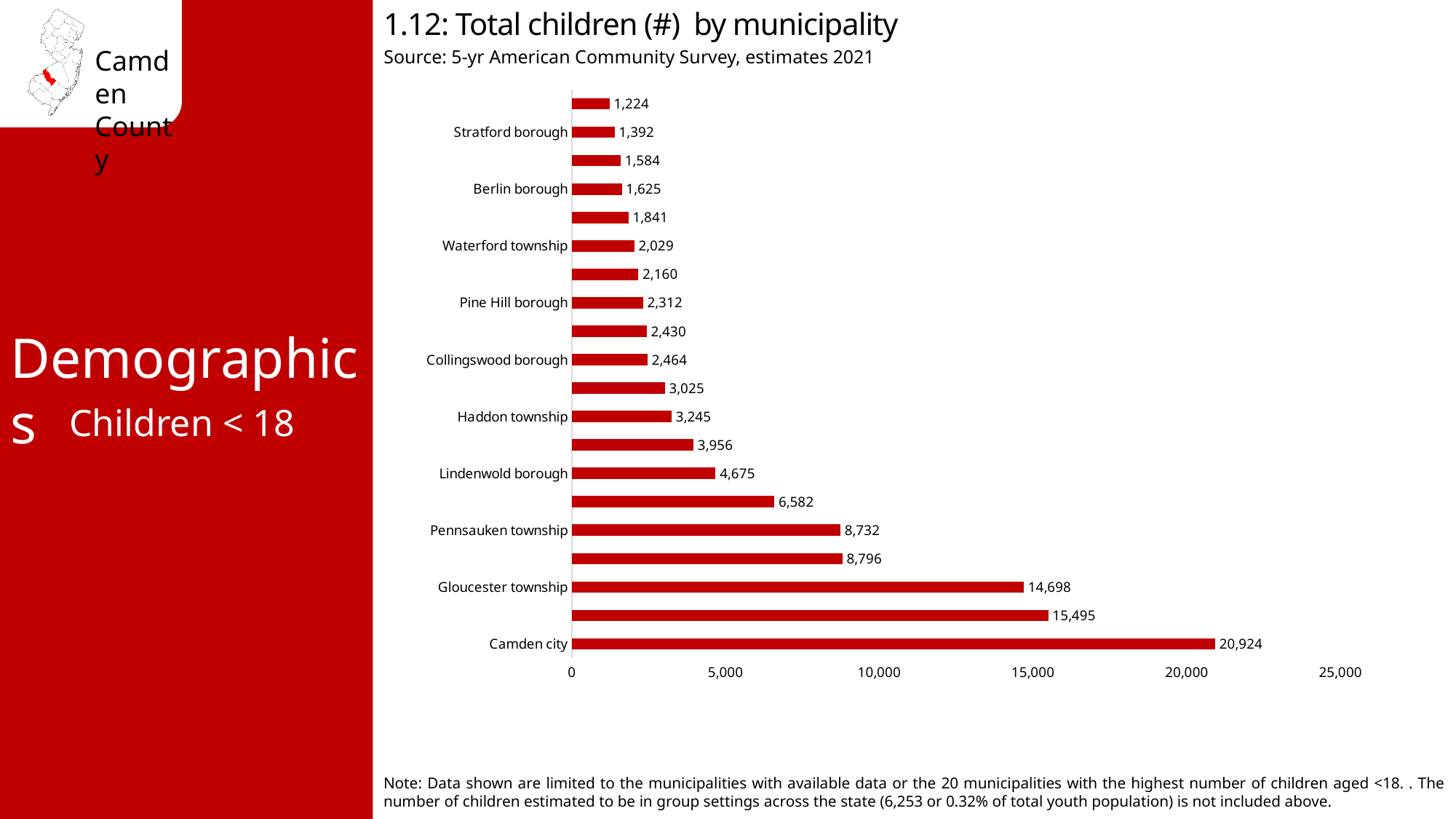
What type of chart is shown on the slide? bar chart What is the difference between the values for Camden city and Gloucester township? 6,226 Which has a larger value, Haddon township or Collingswood borough? Haddon township How many children are shown for Camden city? 20,924 What is the value for Pennsauken township? 8,732 Is the value for Gloucester township greater or less than 15,000? less What is the value for Stratford borough? 1,392 Which municipality has the highest number of children? Camden city What is the smallest value shown on the chart? 1,224 What is the title of the chart? 1.12: Total children (#) by municipality What is the value for Lindenwold borough? 4,675 How many bars are shown on the chart? 20